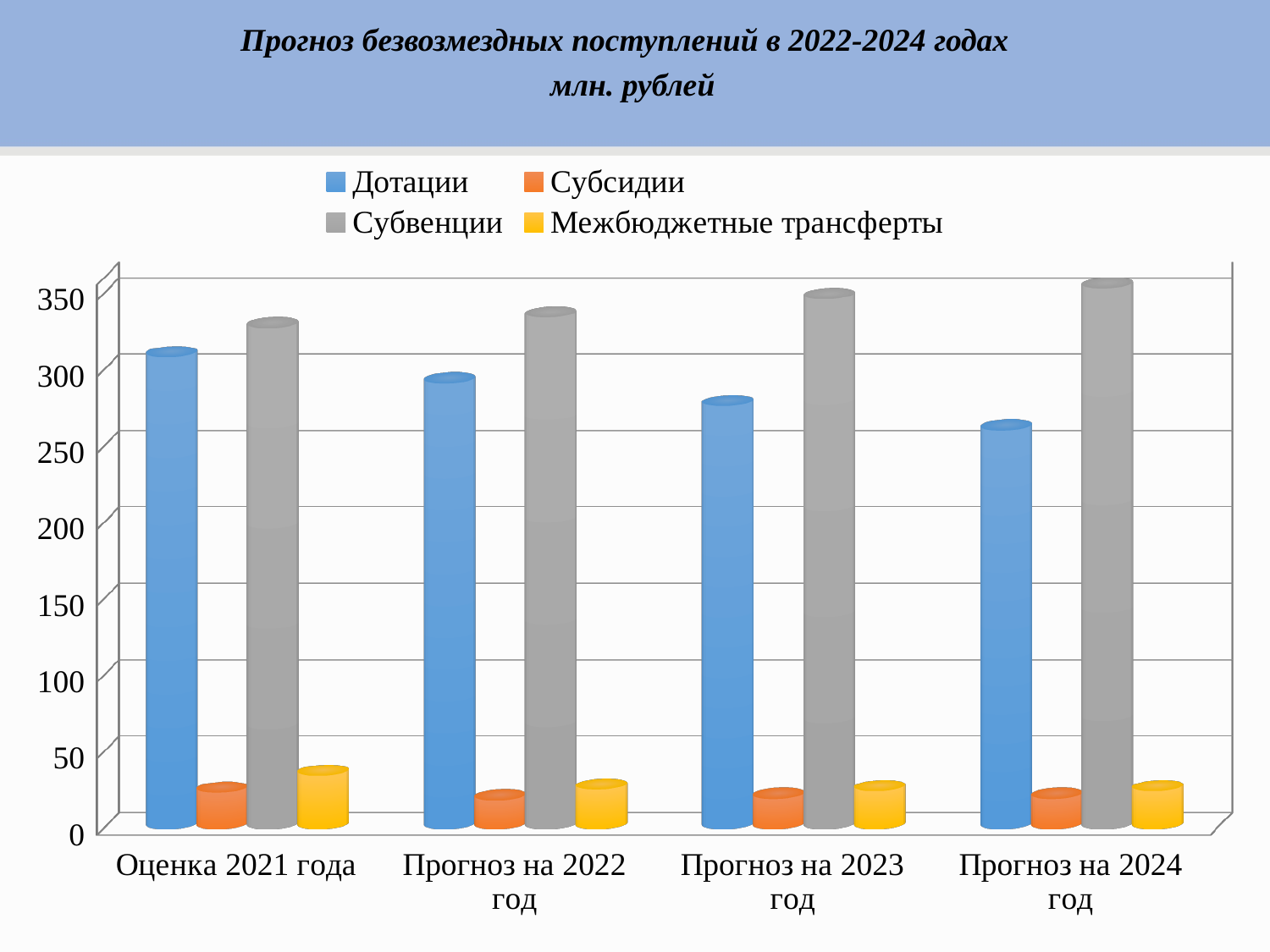
Do the values for Субвенции rise or fall from Оценка 2021 года to Прогноз на 2024 год? rise What kind of chart is shown on the slide? bar chart Is the value for Дотации in Прогноз на 2024 год greater or less than 300? less In Прогноз на 2024 год, which is larger: Дотации or Субвенции? Субвенции Which series has the highest value in Прогноз на 2023 год? Субвенции Is the value for Субсидии in Прогноз на 2022 год greater or less than 50? less Which series has the lowest value in Оценка 2021 года? Субсидии How many categories are shown along the x axis? 4 What colour represents Субвенции in the legend? grey Do the values for Дотации rise or fall from Оценка 2021 года to Прогноз на 2024 год? fall How many series does the legend list? 4 Is the value for Субвенции in Прогноз на 2024 год greater or less than 300? greater